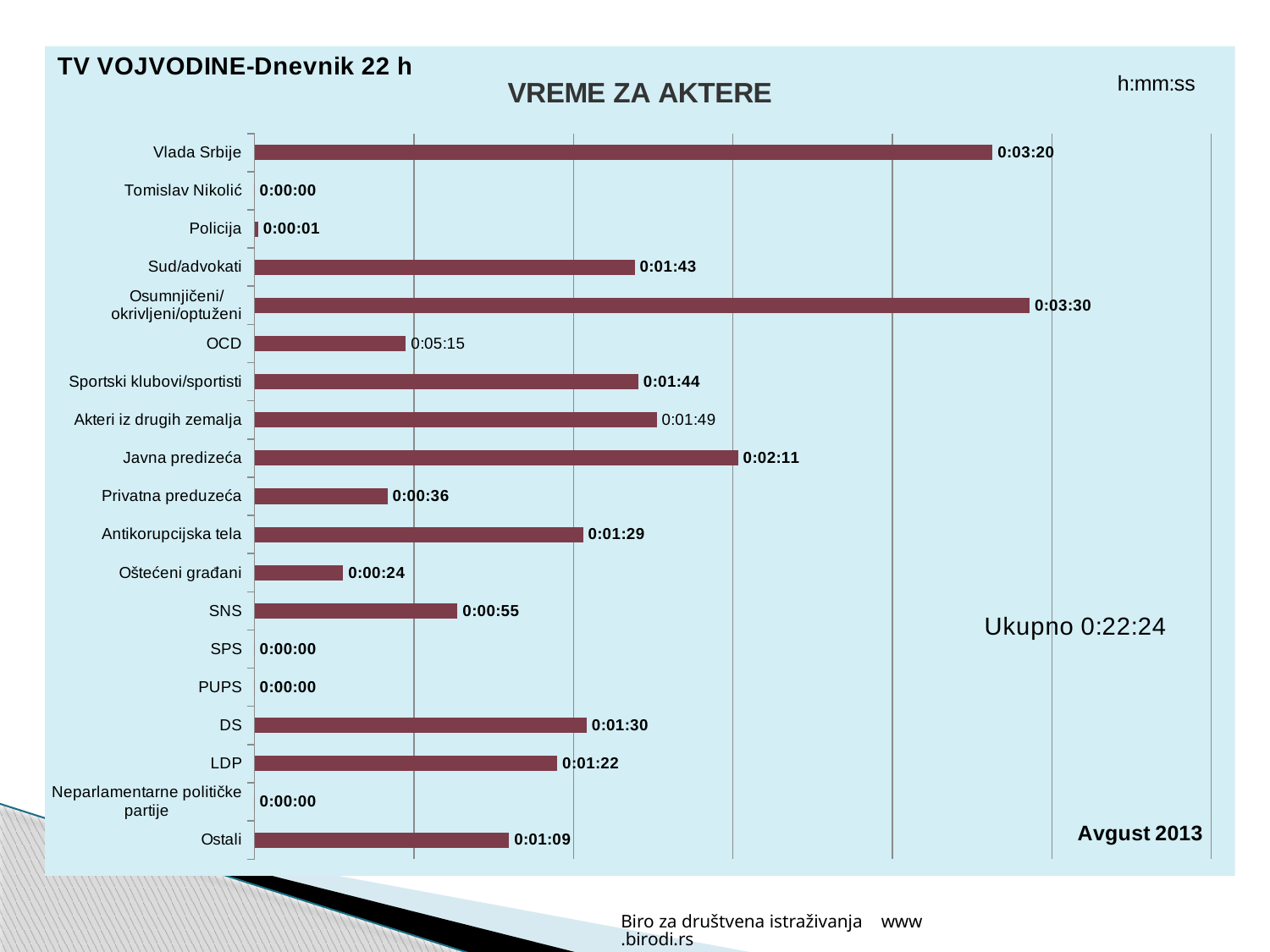
Which is larger, Sportski klubovi/sportisti or Akteri iz drugih zemalja? Akteri iz drugih zemalja What is the value for Osumnjičeni/okrivljeni/optuženi? 0:03:30 What is the value for Policija? 0:00:01 What is the value for Javna predizeća? 0:02:11 What is the difference between DS and LDP? 0:00:08 What is the value for SNS? 0:00:55 What is the value for Vlada Srbije? 0:03:20 What total (Ukupno) is shown on the chart? 0:22:24 How many categories have a value of 0:00:00? 4 What is the difference between Vlada Srbije and Sud/advokati? 0:01:37 How many categories are shown on the chart? 19 What kind of chart is shown? Bar chart